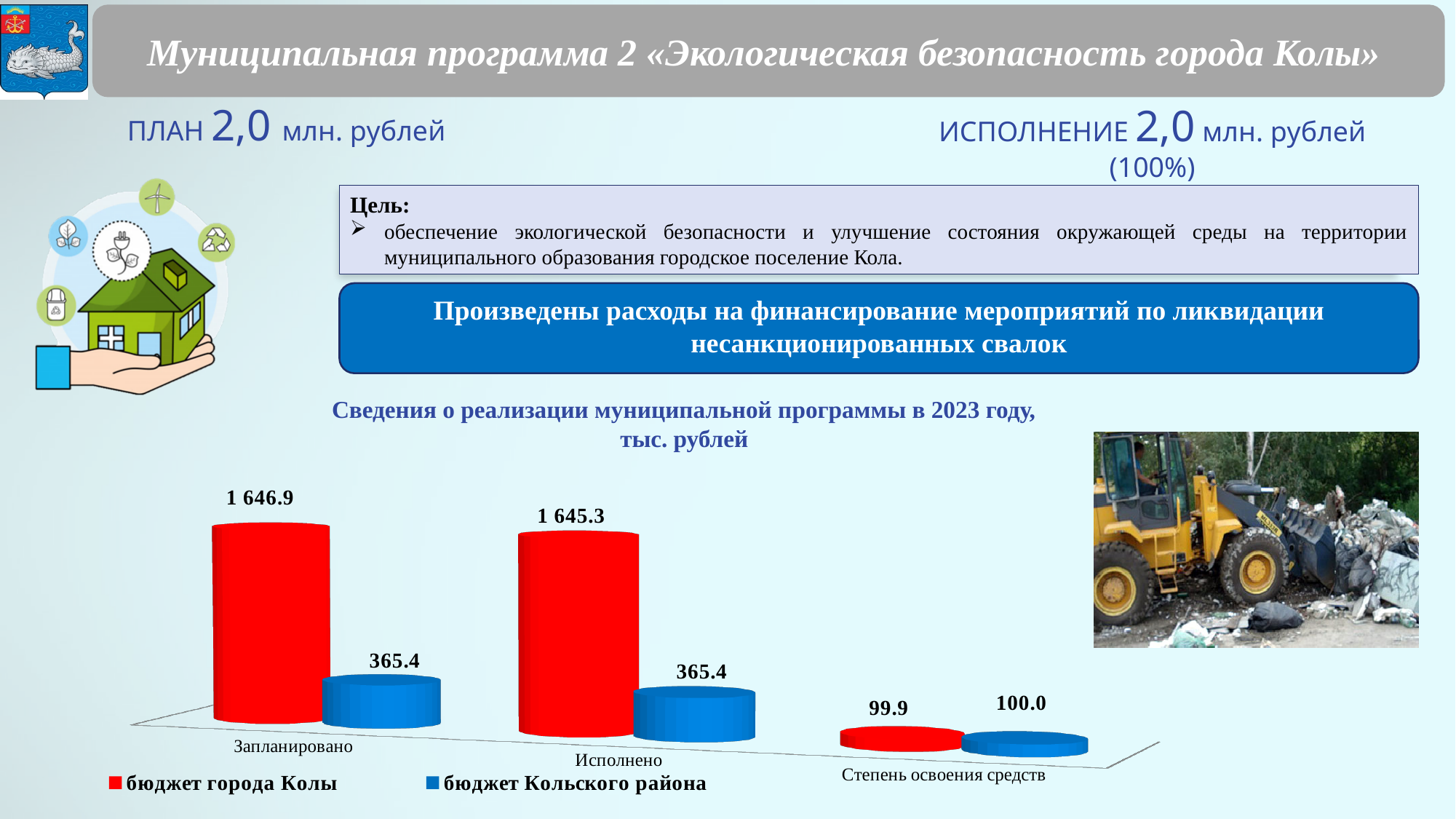
In the «Исполнено» category, which series has the larger value: «бюджет города Колы» or «бюджет Кольского района»? бюджет города Колы Which category has the highest value for «бюджет города Колы»? Запланировано What is the difference between the «бюджет города Колы» values for «Запланировано» and «Исполнено»? 1.6 What is the value for «бюджет города Колы» in the «Степень освоения средств» category? 99.9 What is the value for «бюджет Кольского района» in the «Степень освоения средств» category? 100.0 What is the value for «бюджет города Колы» in the «Запланировано» category? 1 646.9 How many categories are shown on the x axis of the chart? 3 Which category has the lowest value for «бюджет Кольского района»? Степень освоения средств What colour represents «бюджет Кольского района» in the chart? blue What is the value for «бюджет Кольского района» in the «Исполнено» category? 365.4 What type of chart is shown on the slide? bar chart How many series does the chart legend list? 2